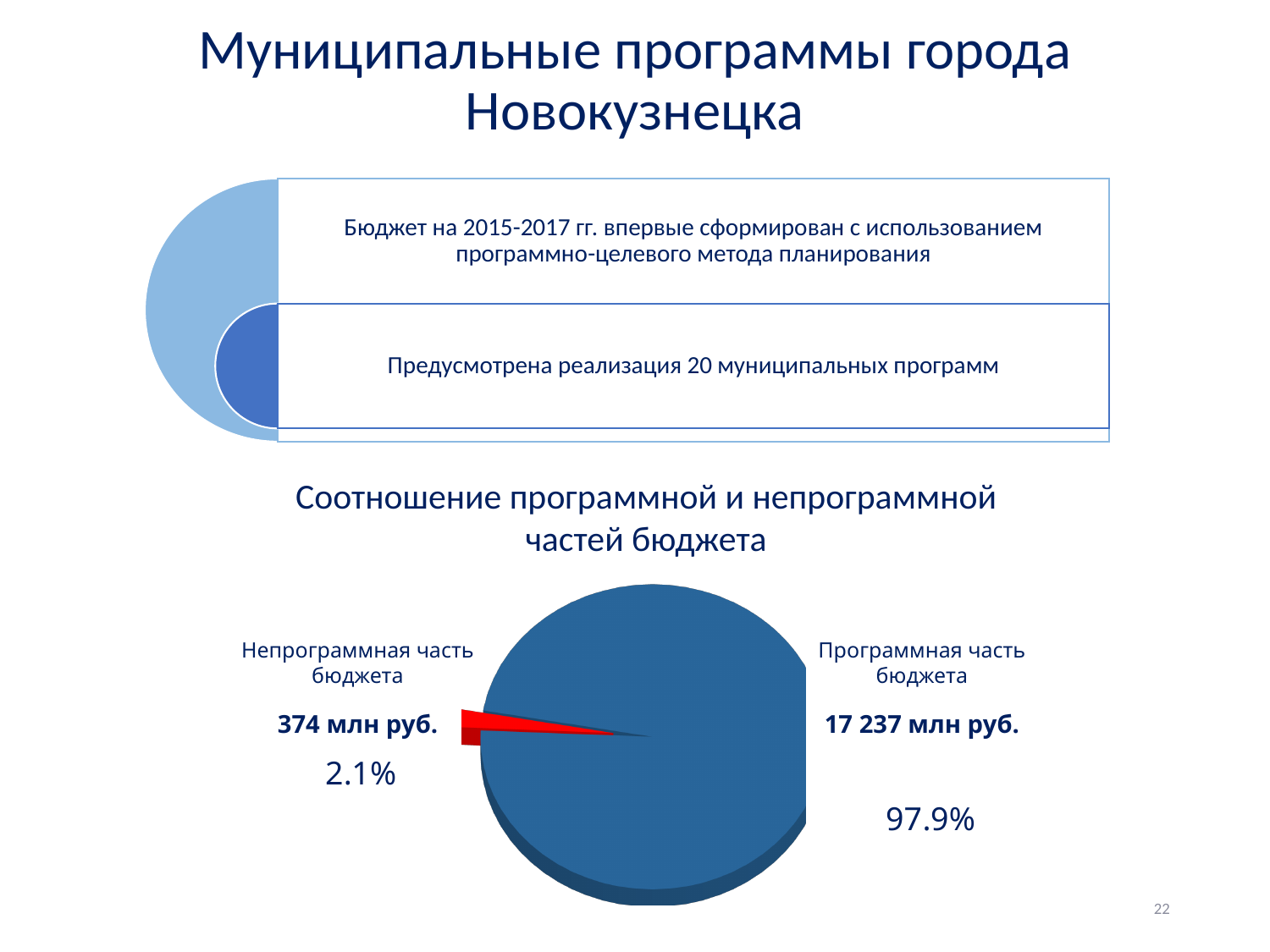
What share of the pie does Непрограммная часть бюджета take? 2.1% How many slices does the pie chart have? 2 What kind of chart is shown on the slide? pie chart What share of the pie does Программная часть бюджета take? 97.9% What is the title of the chart on the slide? Соотношение программной и непрограммной частей бюджета Which slice of the pie is the smallest? Непрограммная часть бюджета What is the value for Непрограммная часть бюджета? 374 млн руб. Which is larger, Программная часть бюджета or Непрограммная часть бюджета? Программная часть бюджета What is the value for Программная часть бюджета? 17 237 млн руб. What colour is the slice for Непрограммная часть бюджета? red Which slice of the pie is the largest? Программная часть бюджета What is the difference between Программная часть бюджета and Непрограммная часть бюджета? 16 863 млн руб.